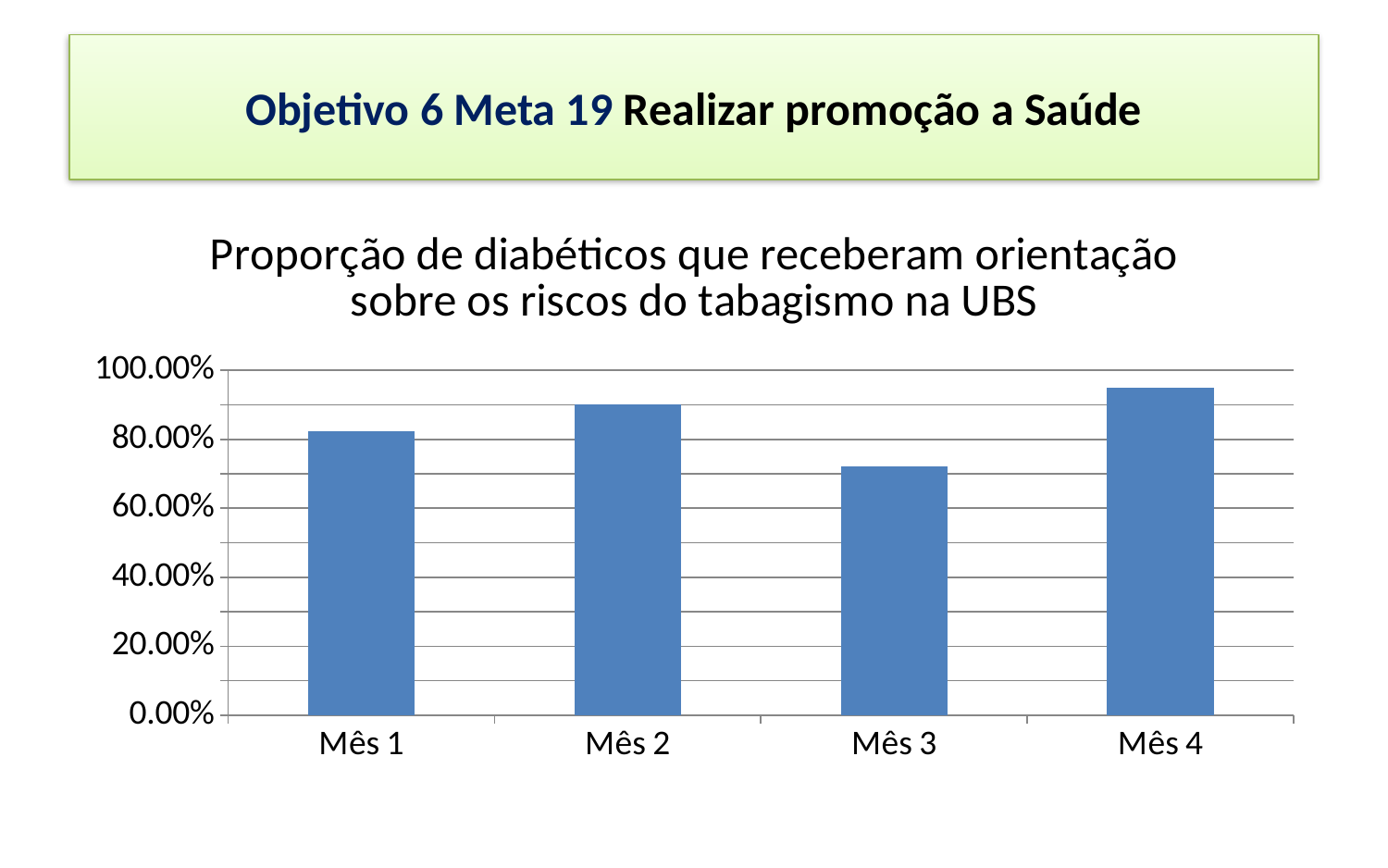
What is the title of the chart? Proporção de diabéticos que receberam orientação sobre os riscos do tabagismo na UBS Which month has the lowest proportion of diabetics who received guidance on the risks of smoking? Mês 3 How many months (categories) are plotted on the chart? 4 Which is larger, the value for Mês 1 or the value for Mês 4? Mês 4 Is the value for Mês 2 greater or less than 100.00%? less Is the value for Mês 4 greater or less than 80.00%? greater Is the value for Mês 1 greater or less than 80.00%? greater What is the highest value shown on the vertical axis? 100.00% Which month has the highest proportion of diabetics who received guidance on the risks of smoking? Mês 4 Which is larger, the value for Mês 2 or the value for Mês 3? Mês 2 What kind of chart is shown on the slide? bar chart